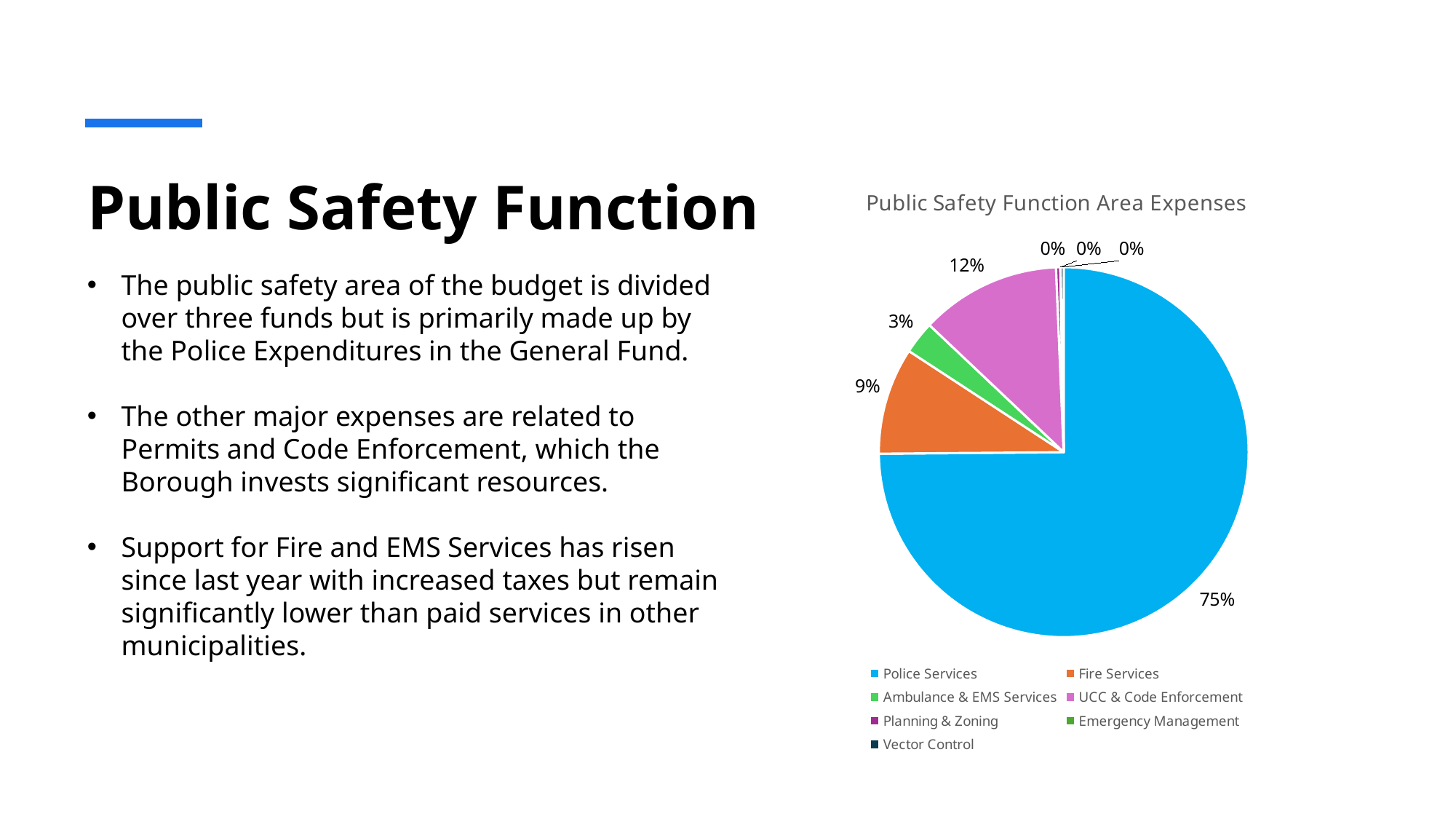
What share of the pie does Police Services represent? 75% How many categories does the legend list? 7 What is the difference in percentage points between the Police Services share and the UCC & Code Enforcement share? 63 What is the title of the chart? Public Safety Function Area Expenses What share of the pie does Ambulance & EMS Services represent? 3% What is the difference in percentage points between the Fire Services share and the Ambulance & EMS Services share? 6 Which category has the largest share of the pie? Police Services Which is larger, the share for Fire Services or the share for UCC & Code Enforcement? UCC & Code Enforcement What colour is the Police Services slice? Blue What share of the pie does Fire Services represent? 9% What type of chart is shown on the slide? Pie chart